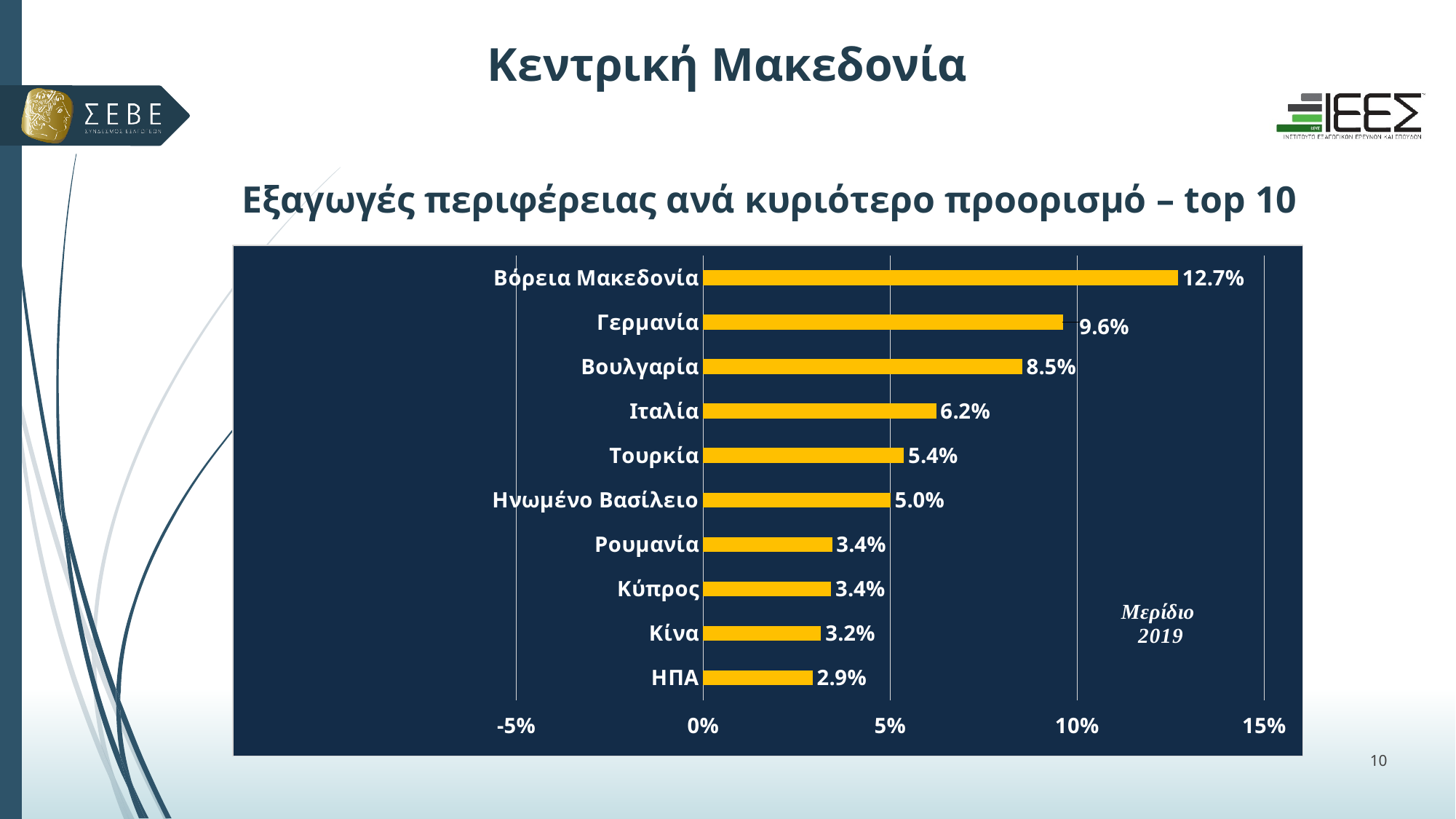
What is the value for Βόρεια Μακεδονία? 12.7% What year is indicated in the text inside the chart area? 2019 Which destination has the lowest share? ΗΠΑ What is the value for Γερμανία? 9.6% What is the difference between the values for Βόρεια Μακεδονία and Γερμανία? 3.1% Which destination has the highest share? Βόρεια Μακεδονία How many destinations are shown in the chart? 10 What is the difference between the values for Ιταλία and Τουρκία? 0.8% What is the value for ΗΠΑ? 2.9% What is the value for Τουρκία? 5.4% Which is larger, the value for Βουλγαρία or the value for Ιταλία? Βουλγαρία What kind of chart is shown on the slide? Bar chart